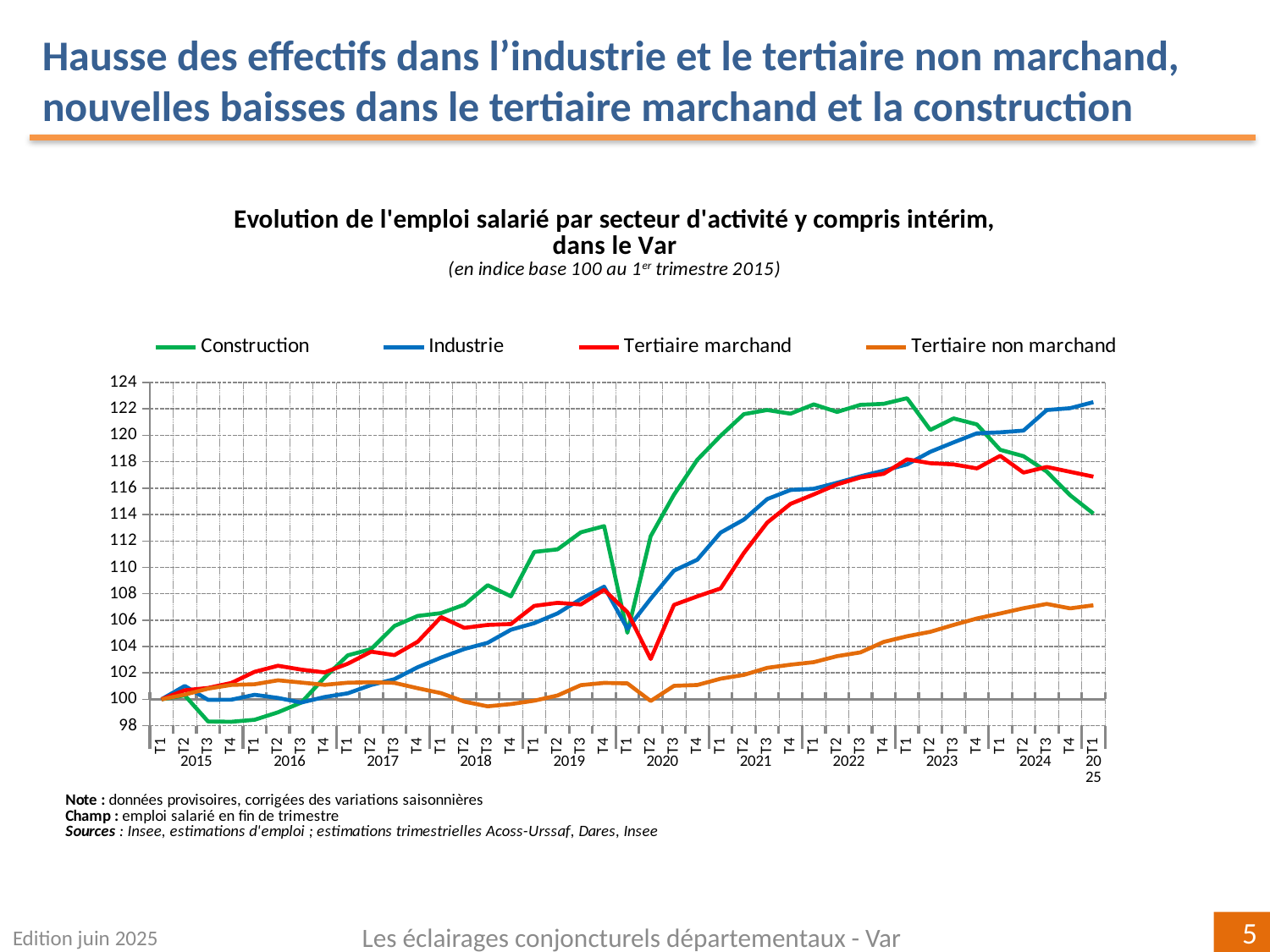
Is the value for Tertiaire marchand at T2 2020 greater or less than 106? less What is the base period of the index used in the chart? 1er trimestre 2015 (base 100) Does the Construction series rise or fall between T1 2023 and T1 2025? fall What kind of chart is shown on the slide? line chart Does the Tertiaire non marchand series rise or fall between T1 2021 and T1 2025? rise Is the value for Industrie at T1 2025 greater or less than 120? greater How many series does the legend list? 4 At T1 2025, which is larger: Industrie or Construction? Industrie Which series has the lowest value at T1 2025? Tertiaire non marchand Is the value for Tertiaire non marchand at T1 2025 greater or less than 110? less Which series has the highest value at T1 2025? Industrie